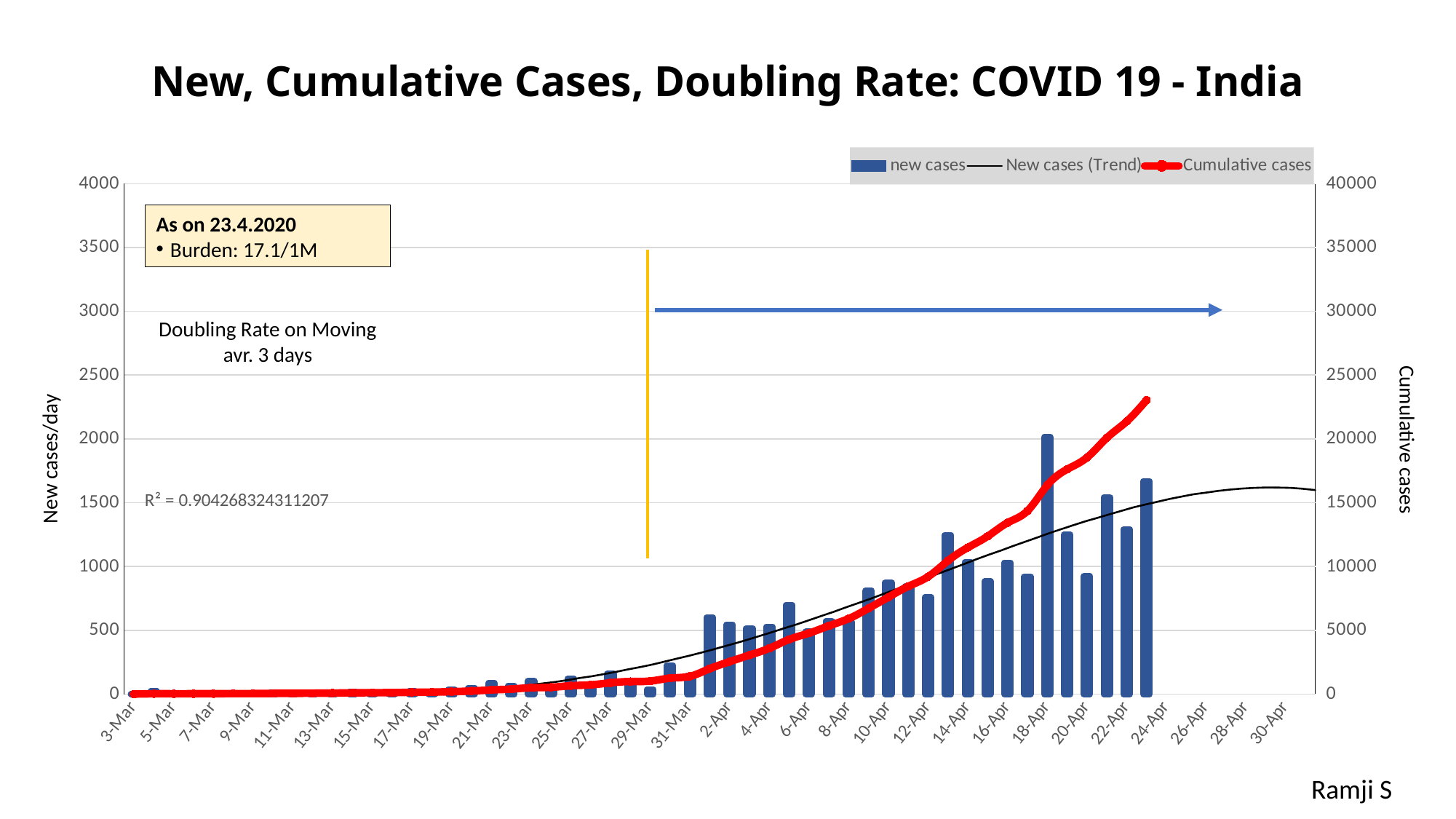
Which date has the larger new cases bar, 18-Apr or 20-Apr? 18-Apr Is the new cases value for 2-Apr greater or less than 1000? less What colour is the 'Cumulative cases' line in the chart? red On which date is the bar for new cases the highest? 18-Apr Do the cumulative cases rise or fall from 3-Mar to 23-Apr? rise Which date has the larger new cases bar, 21-Apr or 22-Apr? 21-Apr What kind of chart is used to plot the 'new cases' series? bar chart Is the cumulative cases value on 31-Mar greater or less than 5000? less Is the cumulative cases value on 23-Apr greater or less than 20000? greater How many series does the chart legend list? 3